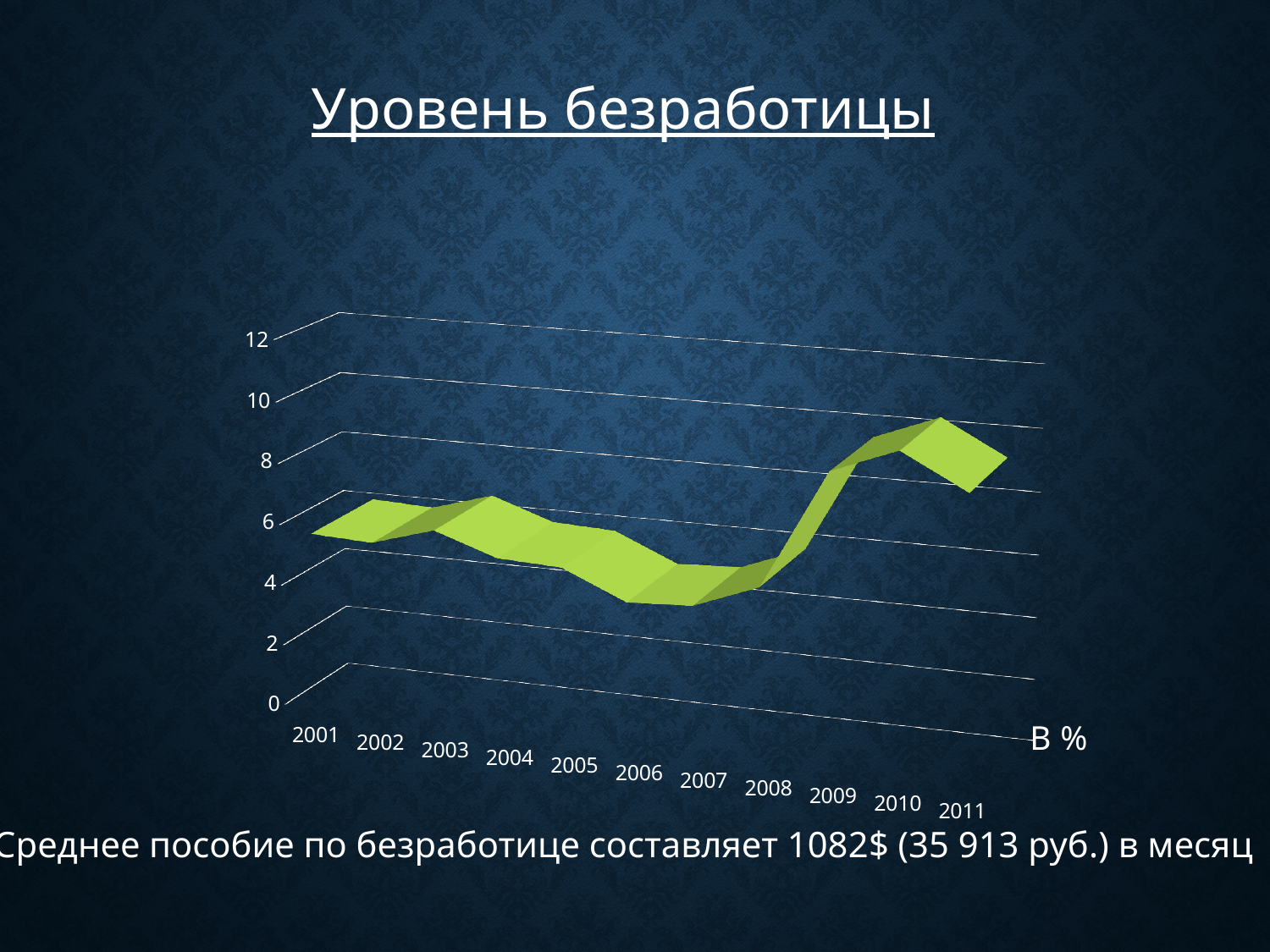
Is the value for 2007 greater or less than 6? less Which year has the highest unemployment rate in the chart? 2010 What label is shown for the data series at the end of the x axis? В % What kind of chart is shown on the slide? line chart Do the values rise or fall from 2008 to 2010? rise Which is larger, the value for 2003 or the value for 2009? 2009 Is the value for 2009 greater or less than 6? greater How many years are shown on the x axis of the chart? 11 Is the value for 2001 greater or less than 8? less Which is larger, the value for 2010 or the value for 2007? 2010 What is the title of the chart? Уровень безработицы